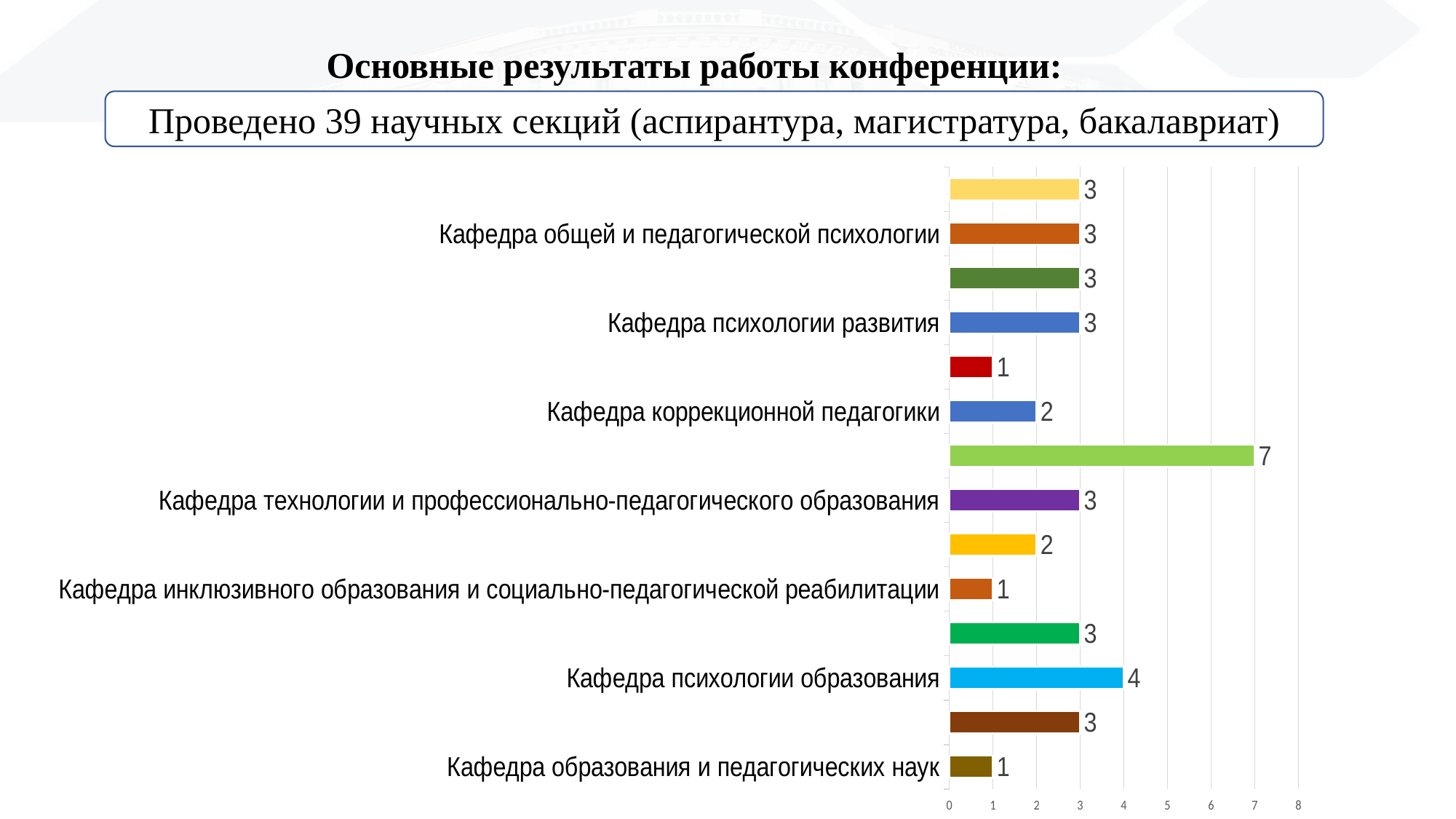
What is the value for Кафедра инклюзивного образования и социально-педагогической реабилитации? 1 What is the largest value shown by any bar in the chart? 7 What is the value for Кафедра психологии развития? 3 Among the categories whose labels are shown, which has the highest value? Кафедра психологии образования Which has a larger value: Кафедра психологии образования or Кафедра коррекционной педагогики? Кафедра психологии образования What is the value for Кафедра общей и педагогической психологии? 3 What is the value for Кафедра коррекционной педагогики? 2 How many bars are plotted in the chart? 14 What is the value for Кафедра образования и педагогических наук? 1 What kind of chart is shown on the slide? bar chart What is the value for Кафедра психологии образования? 4 What is the difference between the values for Кафедра психологии образования and Кафедра коррекционной педагогики? 2